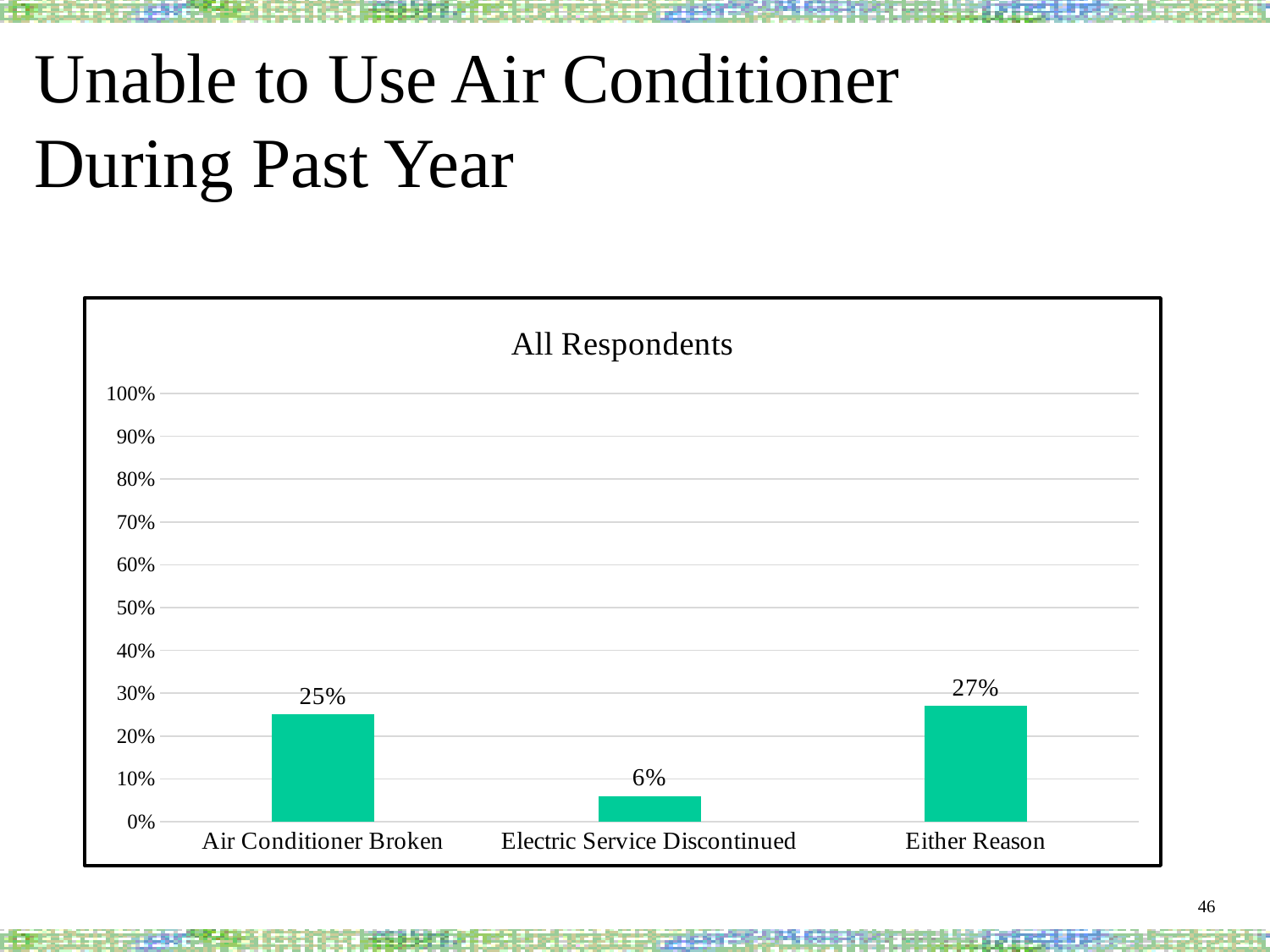
What percentage of respondents were unable to use their air conditioner because it was broken? 25% Which category has the highest value? Either Reason How many categories are shown on the chart? 3 What is the value for Either Reason? 27% What kind of chart is shown on the slide? Bar chart What is the value for Electric Service Discontinued? 6% Is the value for Either Reason greater or less than 50%? less What is the title of the chart? All Respondents Which category has the lowest value? Electric Service Discontinued Which is larger, Air Conditioner Broken or Electric Service Discontinued? Air Conditioner Broken What is the difference between Air Conditioner Broken and Electric Service Discontinued? 19% What is the difference between Either Reason and Air Conditioner Broken? 2%